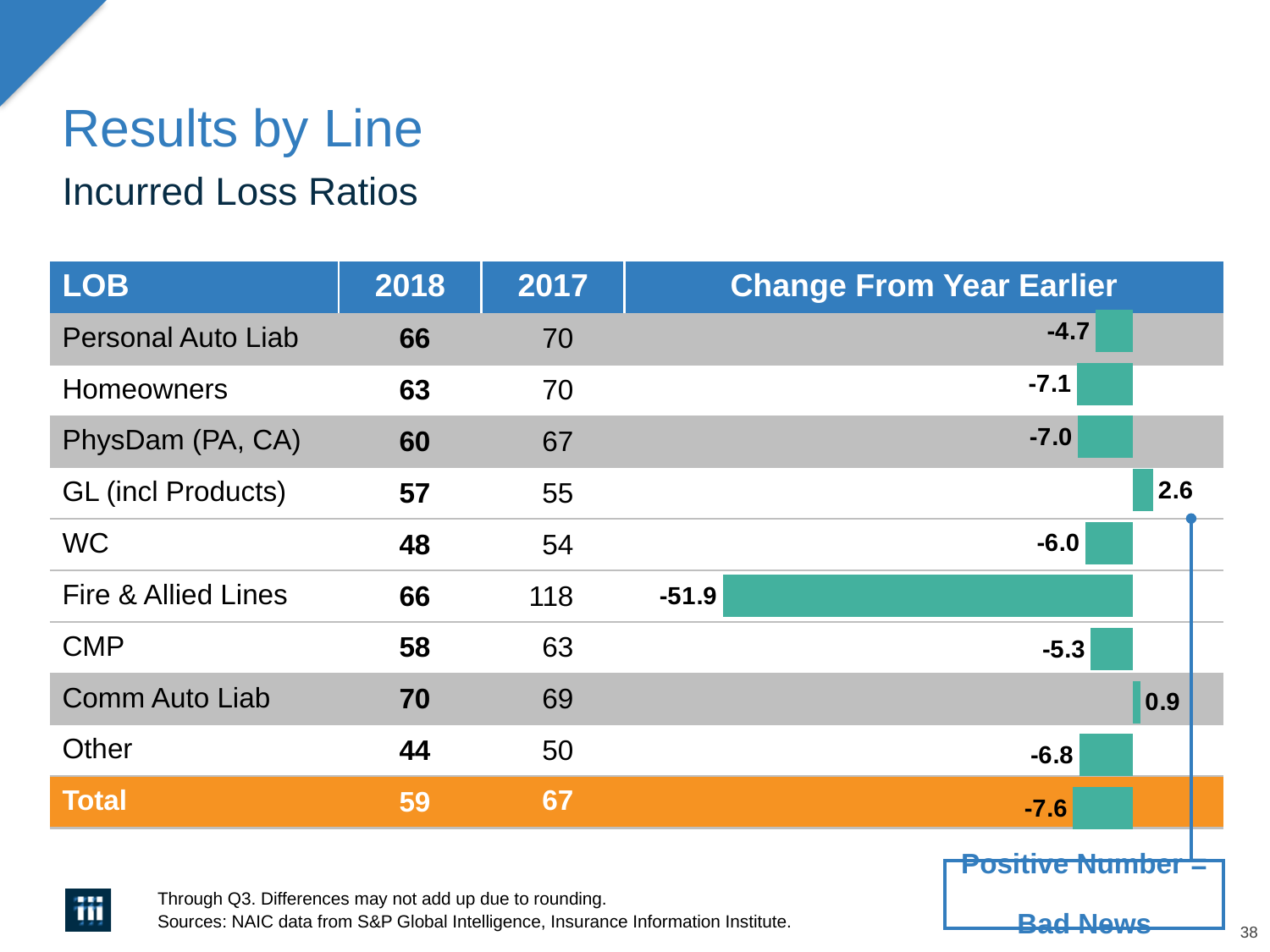
Which has the larger decrease from year earlier, Homeowners or WC? Homeowners What is the change from year earlier shown for Comm Auto Liab? 0.9 Which line of business has the lowest (most negative) change from year earlier? Fire & Allied Lines Which line of business has the largest (most positive) change from year earlier? GL (incl Products) What is the change from year earlier shown for the Total row? -7.6 What is the change from year earlier shown for Homeowners? -7.1 What is the title of the column containing the bar chart? Change From Year Earlier What is the change from year earlier shown for Fire & Allied Lines? -51.9 What is the change from year earlier shown for GL (incl Products)? 2.6 What is the difference between the change from year earlier for Fire & Allied Lines (-51.9) and the Total (-7.6)? 44.3 How many bars are plotted in the Change From Year Earlier chart, including the Total row? 10 What kind of chart is used to show the Change From Year Earlier? Bar chart